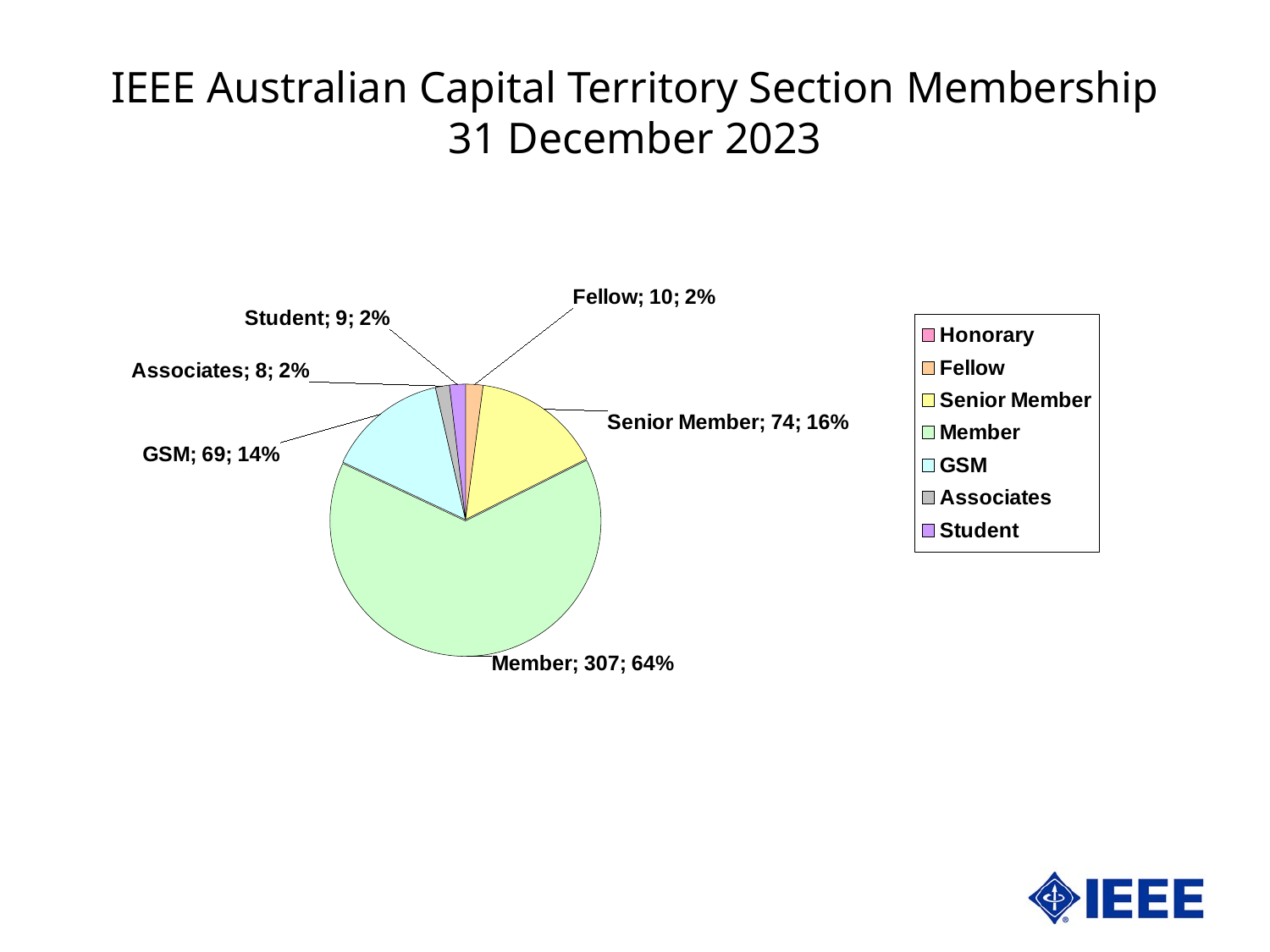
Which labelled category has the smallest count? Associates What type of chart is shown on the slide? pie chart How many members are in the GSM category? 69 Which is larger, the Student count or the Fellow count? Fellow How many entries does the legend list? 7 Which category has the largest slice of the pie? Member What percentage of the membership is Senior Member? 16% What is the count for Fellow? 10 What is the difference between the Senior Member count and the GSM count? 5 What share of the pie does Member represent? 64% How many members are in the Member category? 307 What is the title of the slide? IEEE Australian Capital Territory Section Membership 31 December 2023